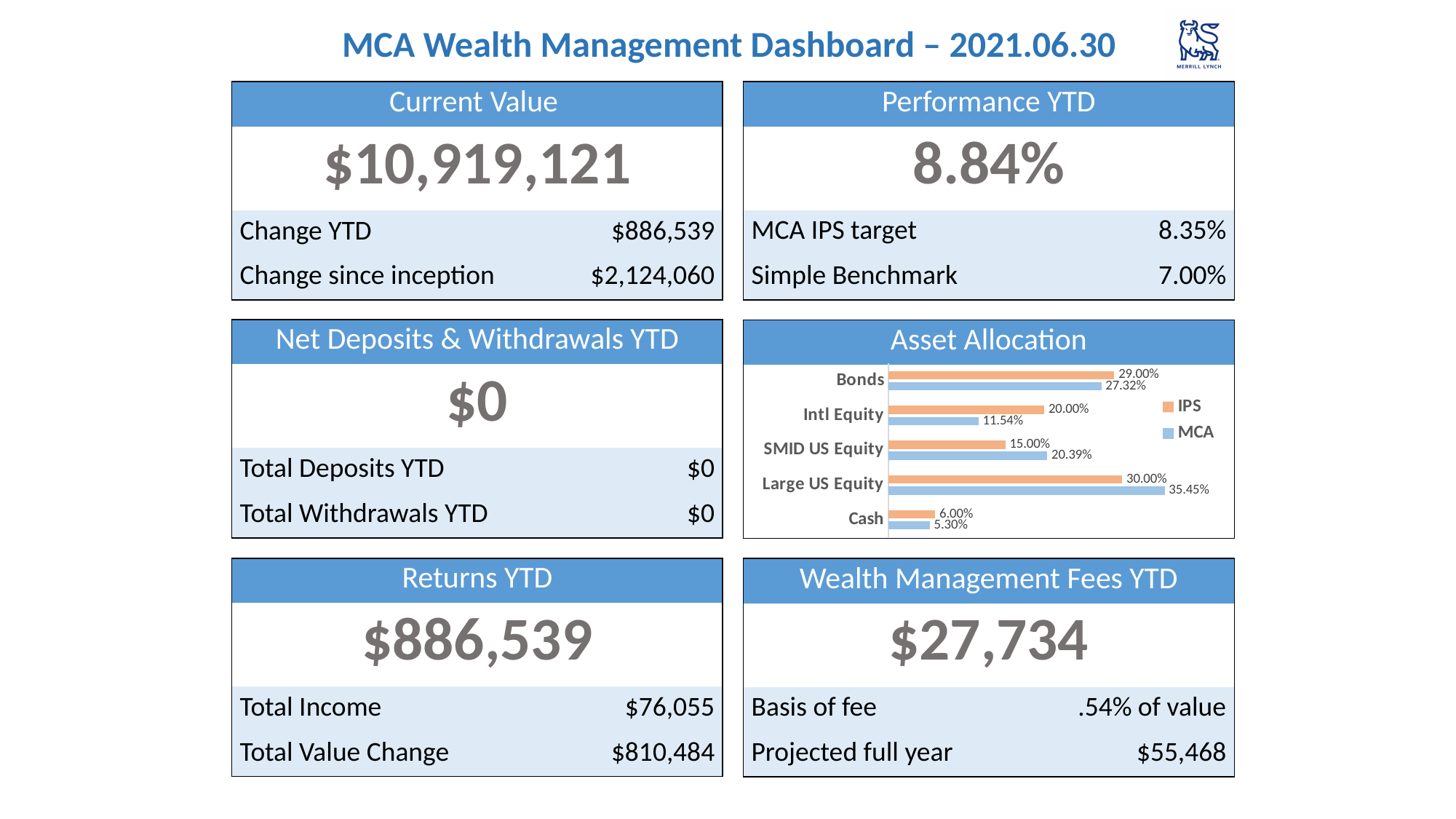
What type of chart is the Asset Allocation chart? Bar chart In the Asset Allocation chart, what is the difference between the MCA and IPS values for Large US Equity? 5.45% In the Asset Allocation chart, what is the MCA value for Intl Equity? 11.54% In the Asset Allocation chart, which is larger for SMID US Equity, the IPS value or the MCA value? MCA In the Asset Allocation chart, which category has the lowest IPS value? Cash In the Asset Allocation chart, which category has the highest MCA value? Large US Equity How many categories are shown in the Asset Allocation chart? 5 In the Asset Allocation chart, what is the IPS value for Cash? 6.00% In the Asset Allocation chart, what is the MCA value for Large US Equity? 35.45% In the Asset Allocation chart, what is the difference between the IPS and MCA values for Intl Equity? 8.46% How many series does the legend of the Asset Allocation chart list? 2 In the Asset Allocation chart, what is the IPS value for Bonds? 29.00%